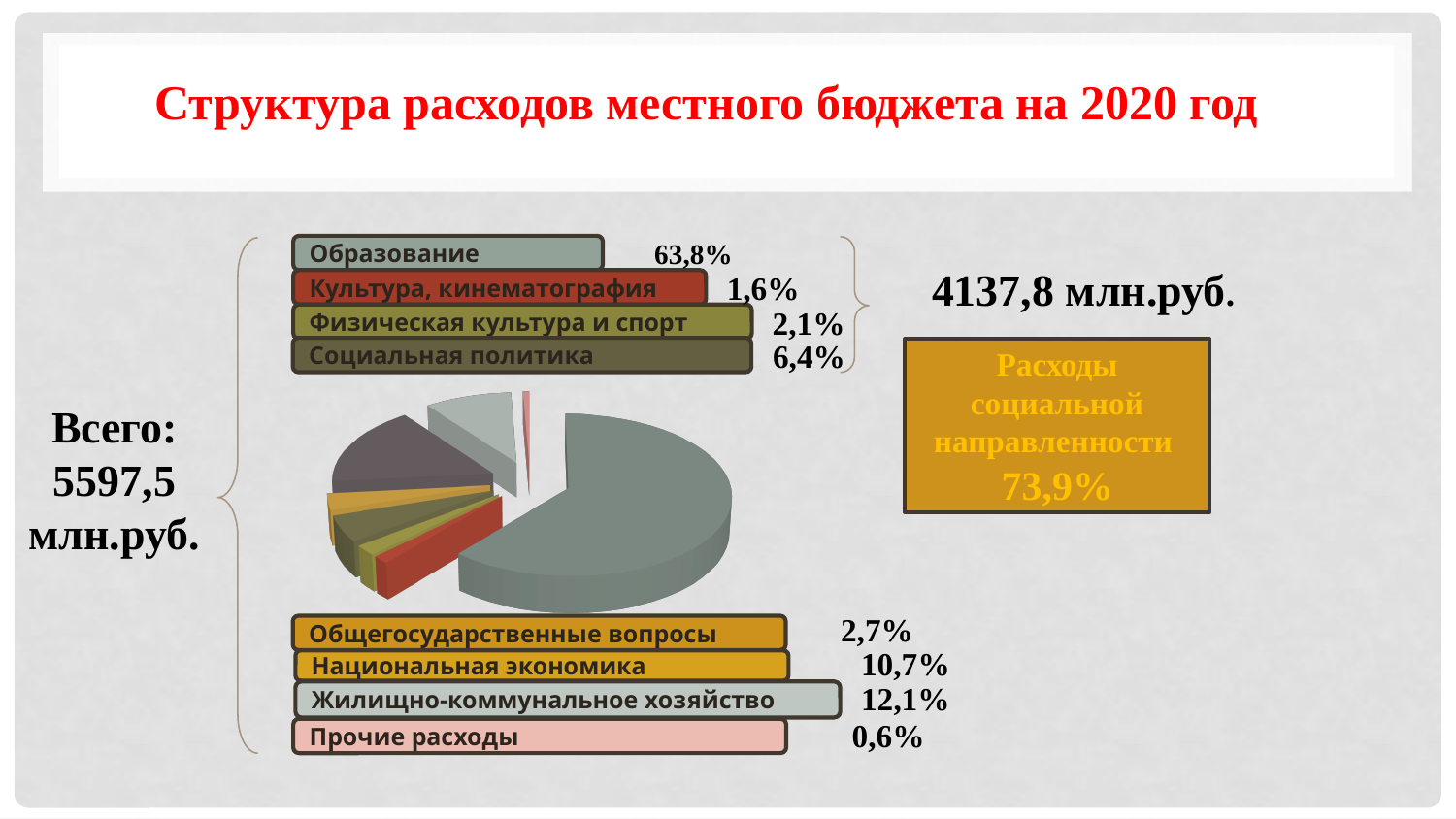
Which expenditure category has the smallest share? Прочие расходы What share of expenditures is labelled as Расходы социальной направленности? 73,9% What is the total amount of local budget expenditures shown on the slide? 5597,5 млн.руб. What share of expenditures is for Социальная политика? 6,4% What share of expenditures is for Жилищно-коммунальное хозяйство? 12,1% What is the difference between the shares for Социальная политика and Общегосударственные вопросы? 3,7% What kind of chart is shown on the slide? pie chart What share of local budget expenditures goes to Образование? 63,8% How many expenditure categories are shown on the chart? 8 Which expenditure category has the largest share? Образование What share of expenditures is for Национальная экономика? 10,7% Which is larger: the share for Национальная экономика or for Жилищно-коммунальное хозяйство? Жилищно-коммунальное хозяйство